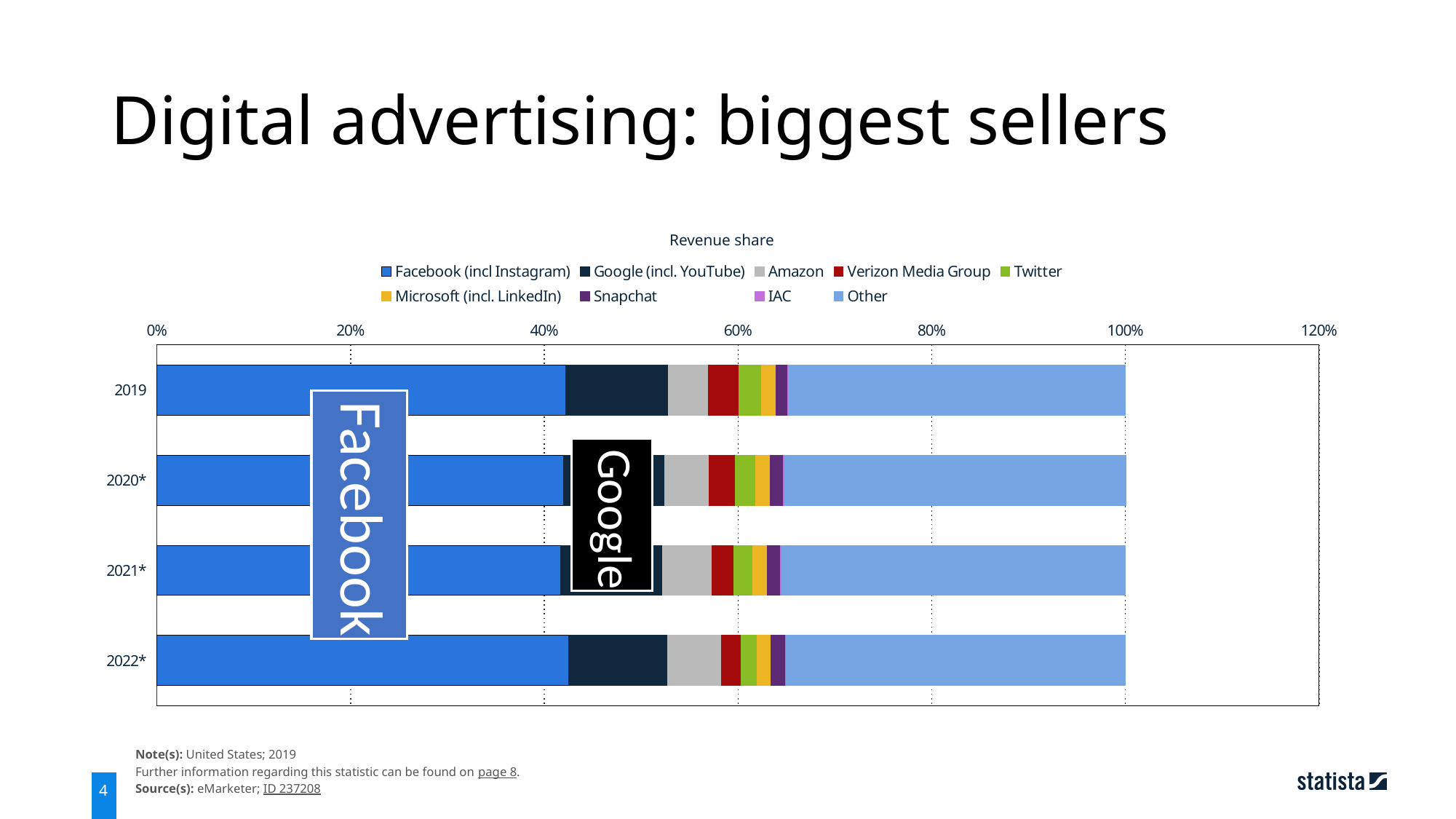
In 2019, which has the larger revenue share: Facebook (incl Instagram) or Google (incl. YouTube)? Facebook (incl Instagram) Is the Facebook (incl Instagram) revenue share for 2019 greater or less than 40%? greater What is the title of the chart on the slide? Revenue share Is the Google (incl. YouTube) revenue share for 2019 greater or less than 20%? less What kind of chart is shown on the slide? Stacked bar chart Which series has the largest revenue share in 2019? Facebook (incl Instagram) How many years (categories) are plotted on the chart? 4 Is the Other revenue share for 2022* greater or less than 20%? greater How many series does the chart legend list? 9 In 2022*, which has the larger revenue share: Other or Amazon? Other What is the total of the stacked bar for 2019? 100%